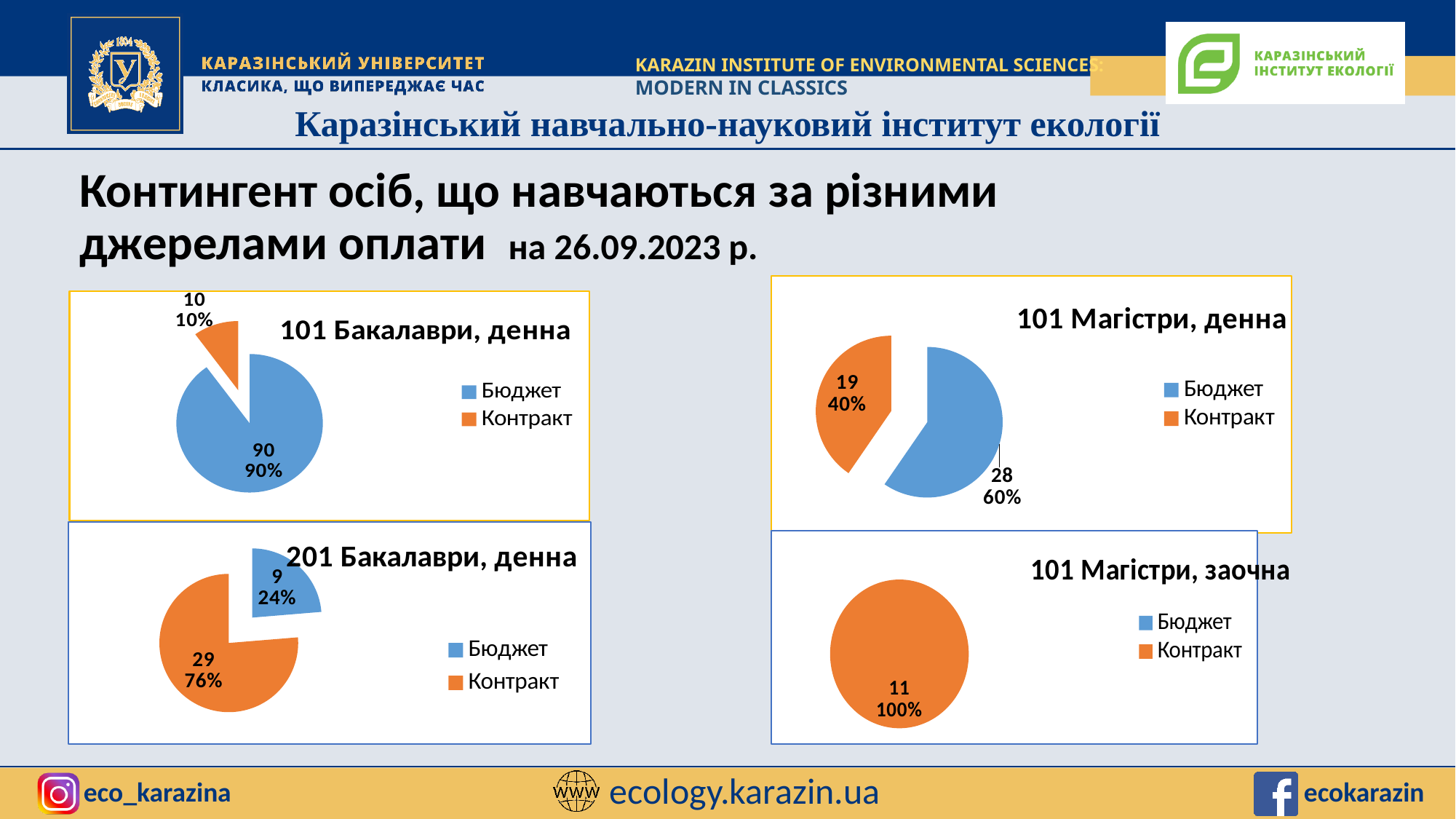
In the chart titled "101 Магістри, денна", what is the difference between the Бюджет and Контракт values? 9 In the chart titled "101 Магістри, заочна", what value is shown for Контракт? 11 In the chart titled "101 Магістри, денна", what value is shown for Бюджет? 28 In the chart titled "201 Бакалаври, денна", what share of the pie is Бюджет? 24% In the chart titled "201 Бакалаври, денна", which is larger, Бюджет or Контракт? Контракт In the chart titled "101 Бакалаври, денна", what share of the pie is Контракт? 10% What kind of chart is "101 Магістри, денна"? Pie chart In the chart titled "101 Бакалаври, денна", what value is shown for Бюджет? 90 How many entries does the legend of the chart titled "101 Магістри, заочна" list? 2 In the chart titled "101 Бакалаври, денна", what is the total of the Бюджет and Контракт values? 100 In the chart titled "101 Бакалаври, денна", which category is the largest? Бюджет In the chart titled "201 Бакалаври, денна", what value is shown for Контракт? 29